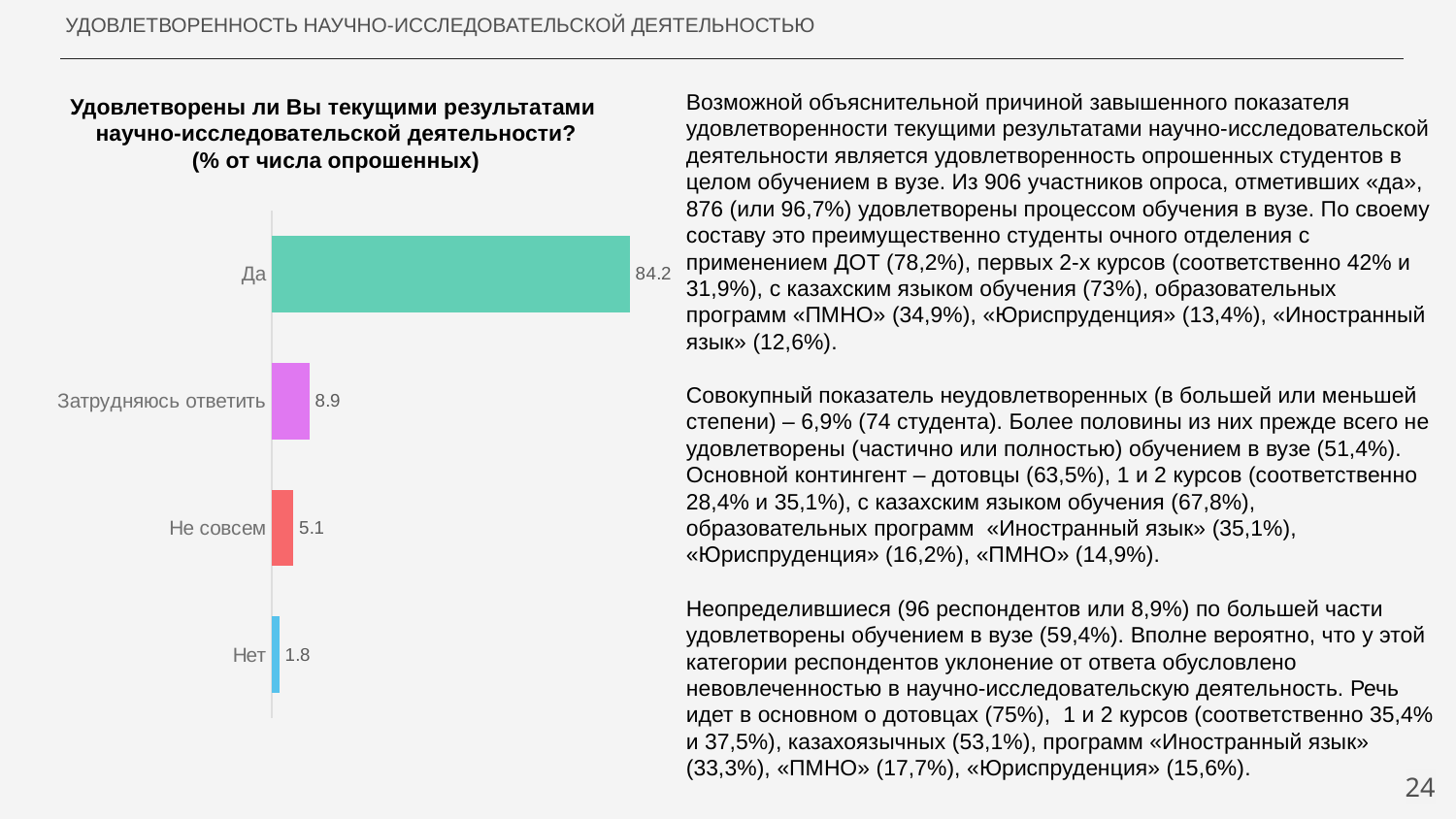
What colour is the bar for «Да»? Green What is the value for «Нет» in the chart? 1.8 What is the difference between the values for «Да» and «Затрудняюсь ответить»? 75.3 What is the difference between the values for «Не совсем» and «Нет»? 3.3 Which is larger, the value for «Затрудняюсь ответить» or the value for «Не совсем»? Затрудняюсь ответить What is the value for «Не совсем» in the chart? 5.1 How many categories are shown in the chart? 4 What is the value for «Да» in the chart? 84.2 Which category has the highest value in the chart? Да What is the value for «Затрудняюсь ответить» in the chart? 8.9 What kind of chart is shown on the slide? Bar chart Which category has the lowest value in the chart? Нет